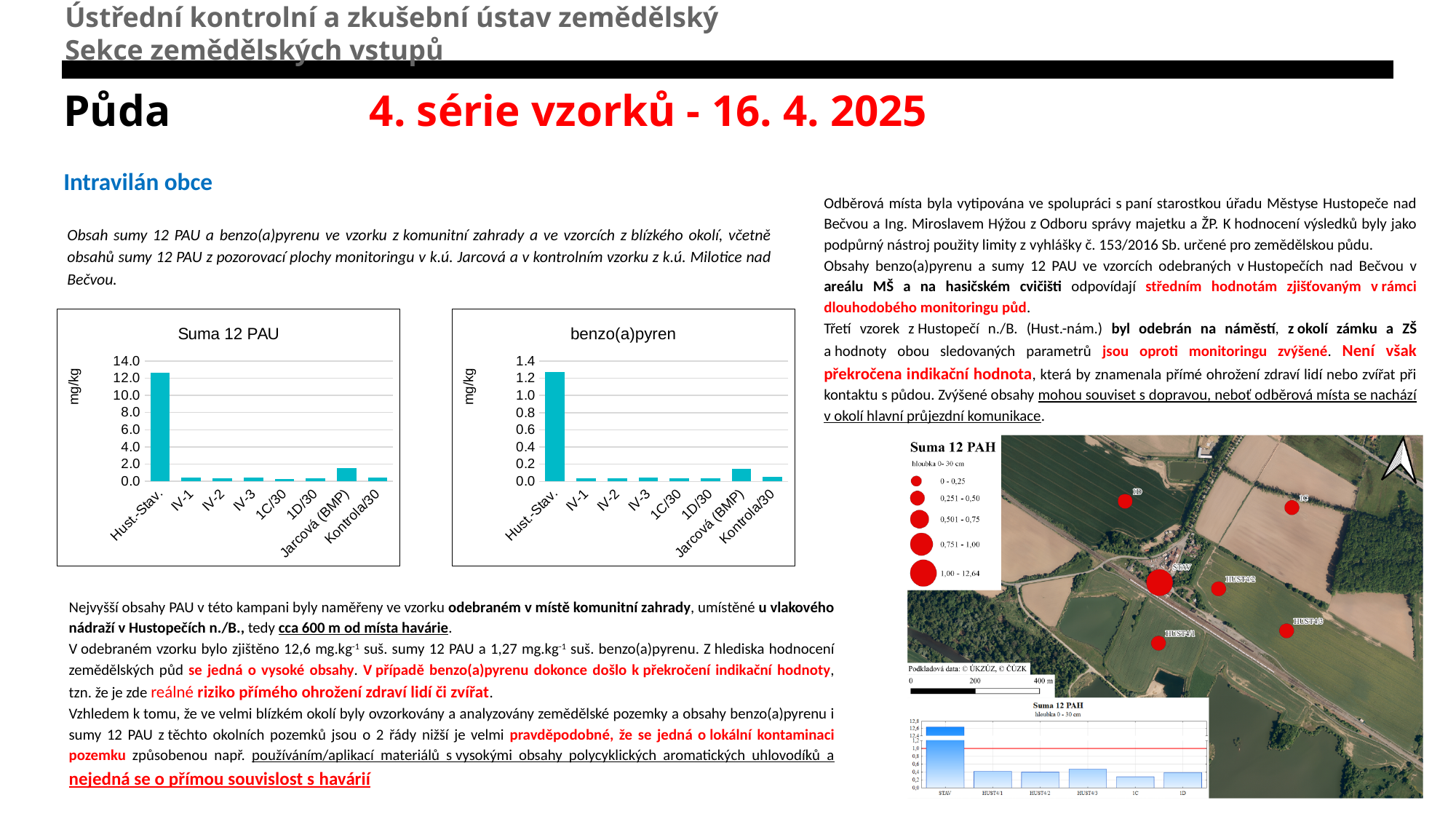
In the "Suma 12 PAU" chart, which category has the highest value? Hust.-Stav. In the "benzo(a)pyren" chart, is the value for Jarcová (BMP) greater or less than 0.4? less In the "benzo(a)pyren" chart, is the value for Hust.-Stav. greater or less than 1.0? greater In the "Suma 12 PAU" chart, is the value for Hust.-Stav. greater or less than 10.0? greater What unit is shown on the y axis of the "Suma 12 PAU" chart? mg/kg In the "benzo(a)pyren" chart, which category has the highest value? Hust.-Stav. In the "Suma 12 PAU" chart, which is larger: the value for Jarcová (BMP) or the value for IV-1? Jarcová (BMP) What is the title of the right-hand bar chart on the left side of the slide? benzo(a)pyren How many categories are shown on the x axis of the "benzo(a)pyren" chart? 8 What kind of chart is the "Suma 12 PAU" chart? bar chart In the "benzo(a)pyren" chart, which is larger: the value for Jarcová (BMP) or the value for Kontrola/30? Jarcová (BMP)